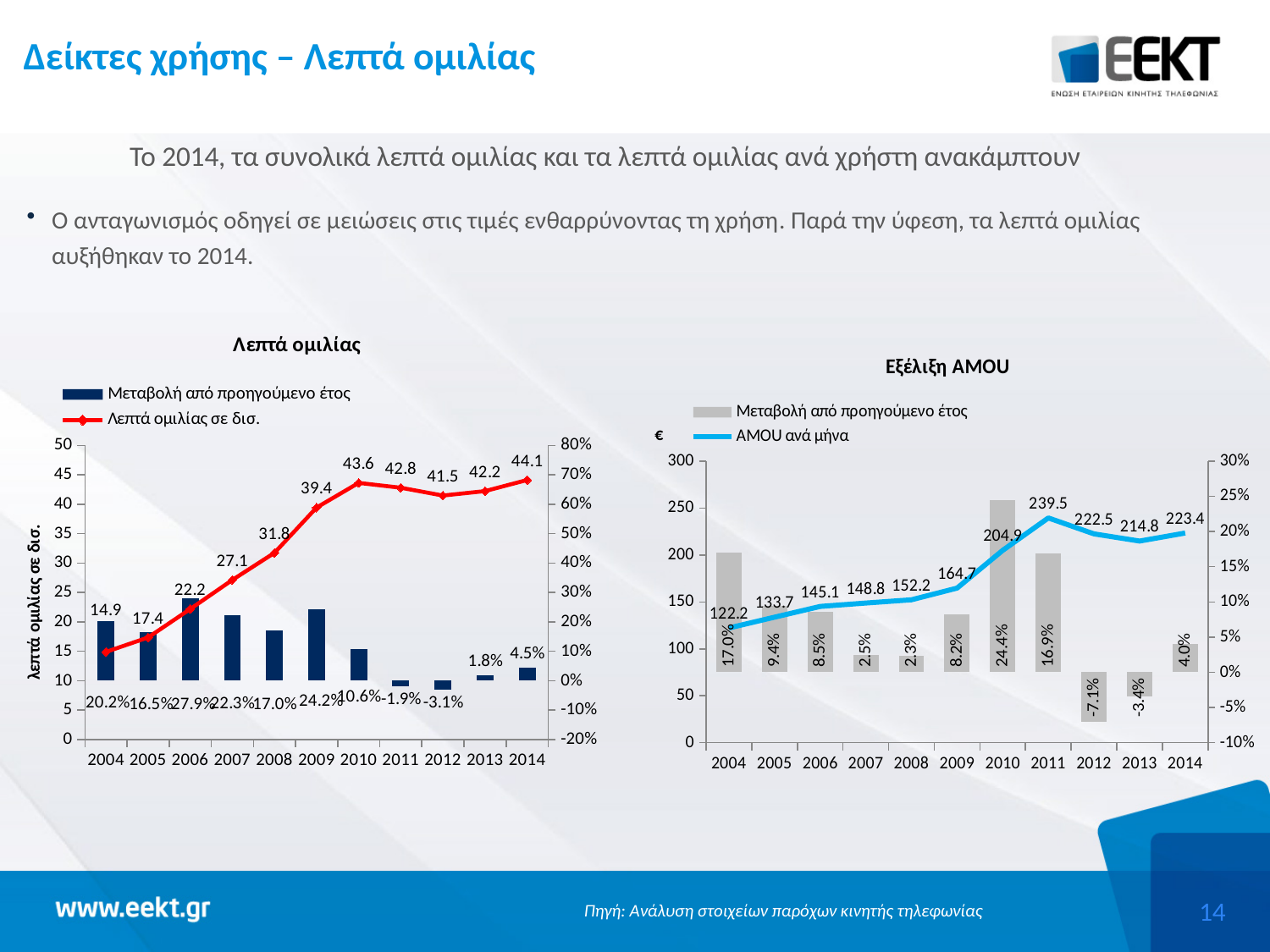
In the 'Εξέλιξη AMOU' chart, which year has the highest 'Μεταβολή από προηγούμενο έτος' value? 2010 In the 'Λεπτά ομιλίας' chart, which year has the highest value of 'Λεπτά ομιλίας σε δισ.'? 2014 In the 'Λεπτά ομιλίας' chart, what is the 'Μεταβολή από προηγούμενο έτος' value for 2006? 27.9% In the 'Λεπτά ομιλίας' chart, which year has the lowest 'Μεταβολή από προηγούμενο έτος' value? 2012 In the 'Εξέλιξη AMOU' chart, what is the 'AMOU ανά μήνα' value for 2011? 239.5 In the 'Λεπτά ομιλίας' chart, how many series does the legend list? 2 In the 'Εξέλιξη AMOU' chart, does the 'AMOU ανά μήνα' line rise or fall from 2004 to 2011? rise In the 'Λεπτά ομιλίας' chart, what is the difference between the 'Λεπτά ομιλίας σε δισ.' values for 2010 and 2004? 28.7 In the 'Εξέλιξη AMOU' chart, which is larger: the 'AMOU ανά μήνα' value for 2013 or for 2014? 2014 In the 'Λεπτά ομιλίας' chart, what is the value of 'Λεπτά ομιλίας σε δισ.' for 2014? 44.1 In the 'Εξέλιξη AMOU' chart, how many years are shown on the x axis? 11 In the 'Εξέλιξη AMOU' chart, what is the 'Μεταβολή από προηγούμενο έτος' value for 2012? -7.1%